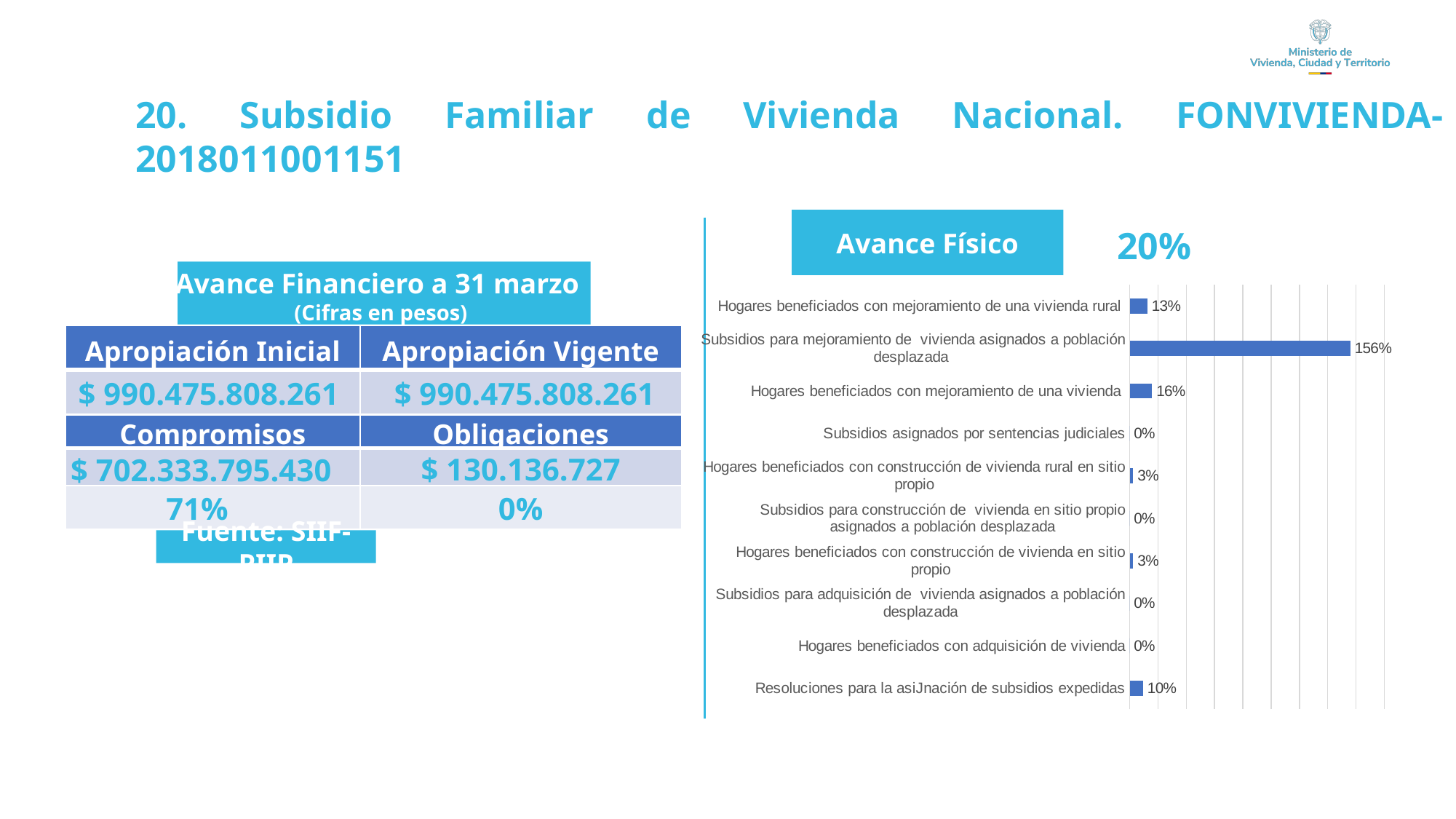
How many categories in the Avance Físico chart have a value of 0%? 4 What is the value for 'Hogares beneficiados con construcción de vivienda rural en sitio propio' in the Avance Físico chart? 3% Which category has the highest value in the Avance Físico chart? Subsidios para mejoramiento de vivienda asignados a población desplazada In the Avance Físico chart, which is larger: 'Hogares beneficiados con mejoramiento de una vivienda rural' or 'Resoluciones para la asiJnación de subsidios expedidas'? Hogares beneficiados con mejoramiento de una vivienda rural What type of chart is the Avance Físico chart? Bar chart What is the value for 'Hogares beneficiados con mejoramiento de una vivienda rural' in the Avance Físico chart? 13% In the Avance Físico chart, what is the difference between 'Hogares beneficiados con mejoramiento de una vivienda' and 'Hogares beneficiados con mejoramiento de una vivienda rural'? 3% What is the value for 'Subsidios asignados por sentencias judiciales' in the Avance Físico chart? 0% How many categories are shown in the Avance Físico chart? 10 What is the value for 'Subsidios para mejoramiento de vivienda asignados a población desplazada' in the Avance Físico chart? 156% What is the value for 'Resoluciones para la asiJnación de subsidios expedidas' in the Avance Físico chart? 10% What is the value for 'Hogares beneficiados con mejoramiento de una vivienda' in the Avance Físico chart? 16%